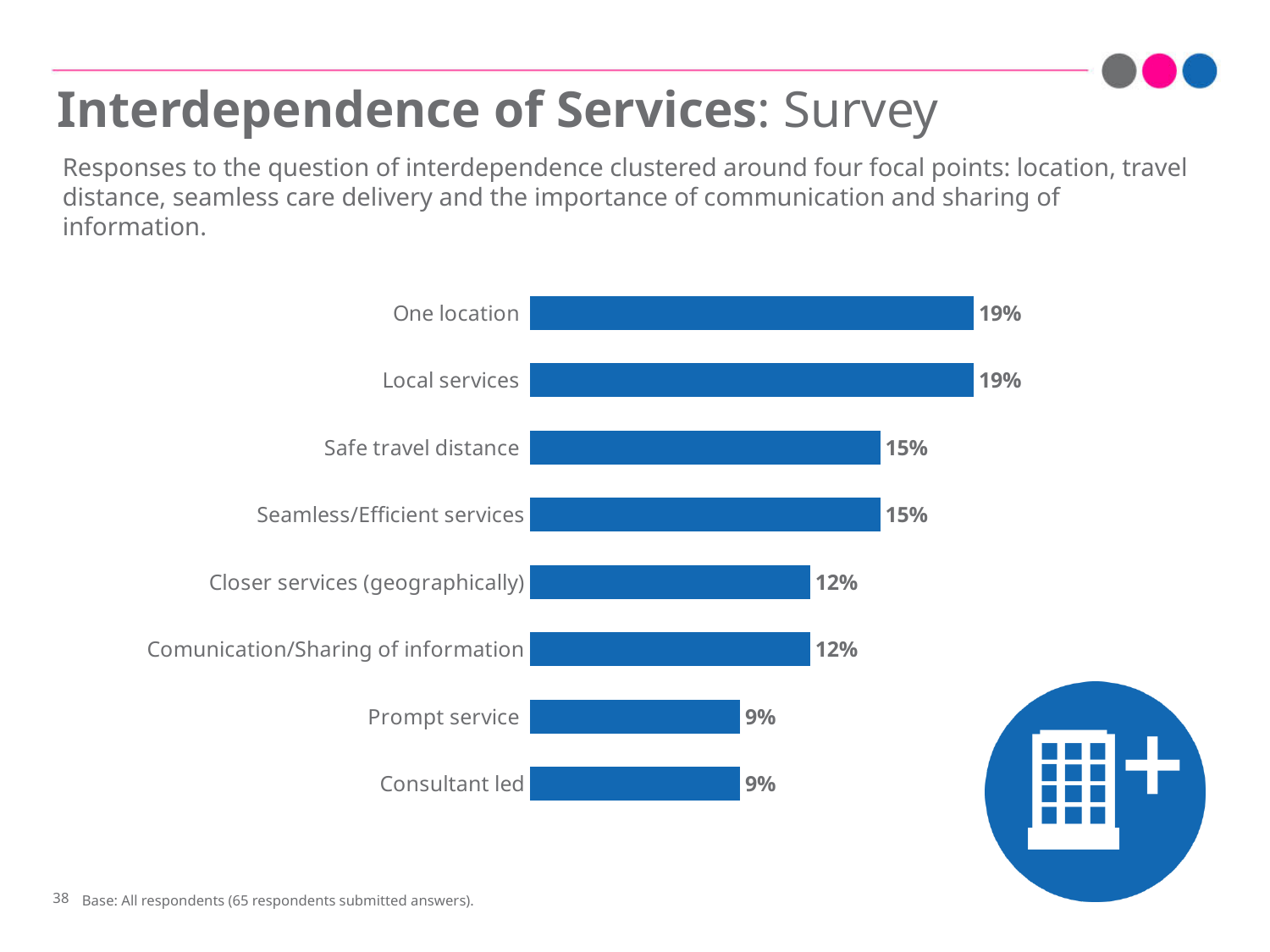
What kind of chart is shown on the slide? Bar chart What is the value for Comunication/Sharing of information? 12% What is the value for Closer services (geographically)? 12% Which is larger, the value for Seamless/Efficient services or the value for Closer services (geographically)? Seamless/Efficient services Which categories have the lowest value? Prompt service and Consultant led What is the value for Safe travel distance? 15% What colour are the bars in the chart? Blue What is the value for One location? 19% How many categories are shown in the chart? 8 Which categories have the highest value? One location and Local services What is the value for Consultant led? 9% What is the difference between the values for Local services and Prompt service? 10%